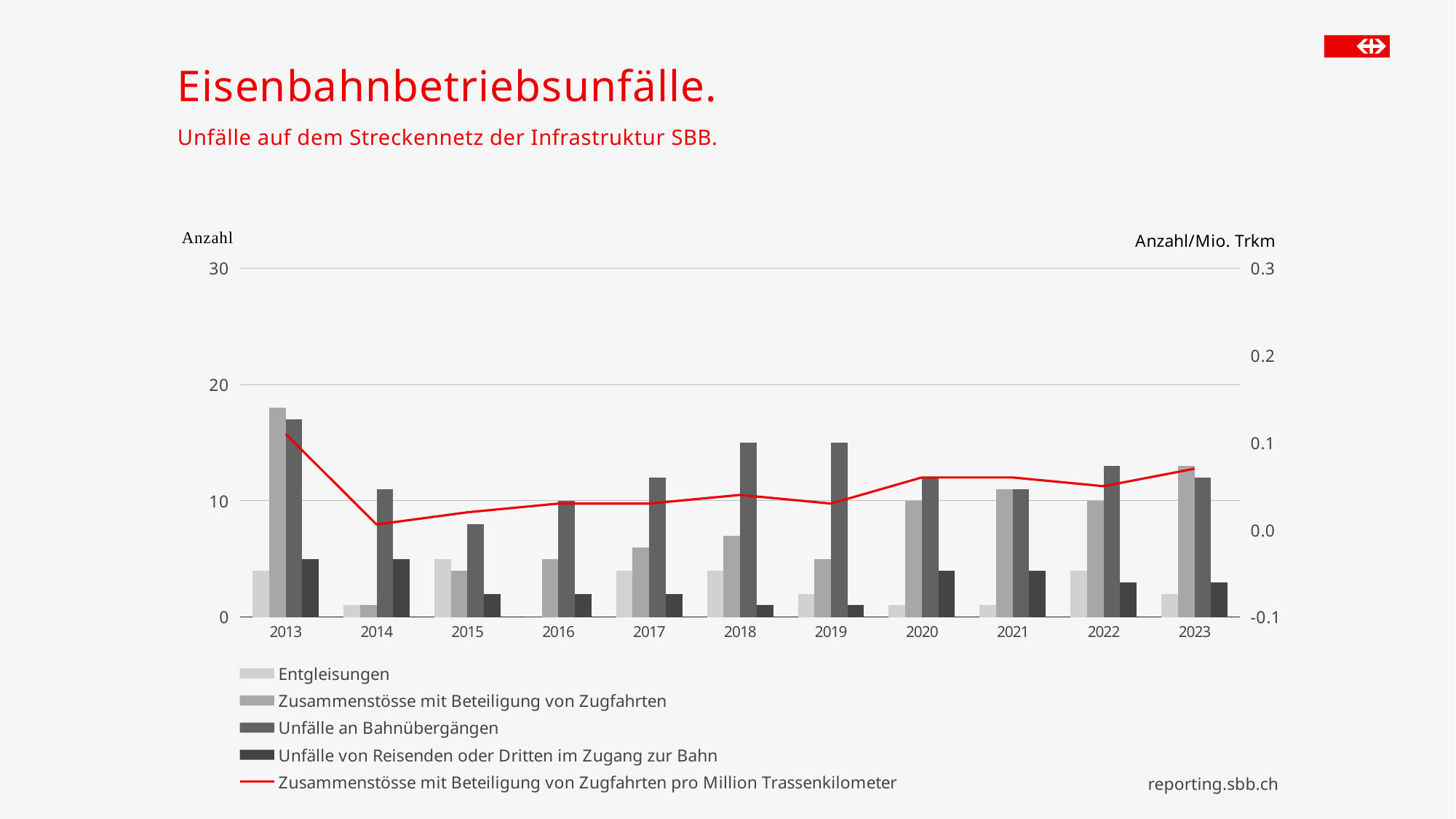
Does the red line for Zusammenstösse mit Beteiligung von Zugfahrten pro Million Trassenkilometer rise or fall from 2013 to 2014? fall How many years are shown on the x axis? 11 Is the value for Unfälle an Bahnübergängen in 2018 greater or less than 10? greater What kind of chart is shown on the slide? Bar chart combined with a line In which year is the value for Unfälle an Bahnübergängen highest? 2013 In 2019, which is larger: Unfälle an Bahnübergängen or Zusammenstösse mit Beteiligung von Zugfahrten? Unfälle an Bahnübergängen In which year is the value for Zusammenstösse mit Beteiligung von Zugfahrten highest? 2013 Is the value for Zusammenstösse mit Beteiligung von Zugfahrten in 2013 greater or less than 10? greater In which year is the value for Zusammenstösse mit Beteiligung von Zugfahrten lowest? 2014 Is the value for Unfälle an Bahnübergängen in 2015 greater or less than 10? less What is the title of the chart on the slide? Eisenbahnbetriebsunfälle. How many series does the legend list? 5